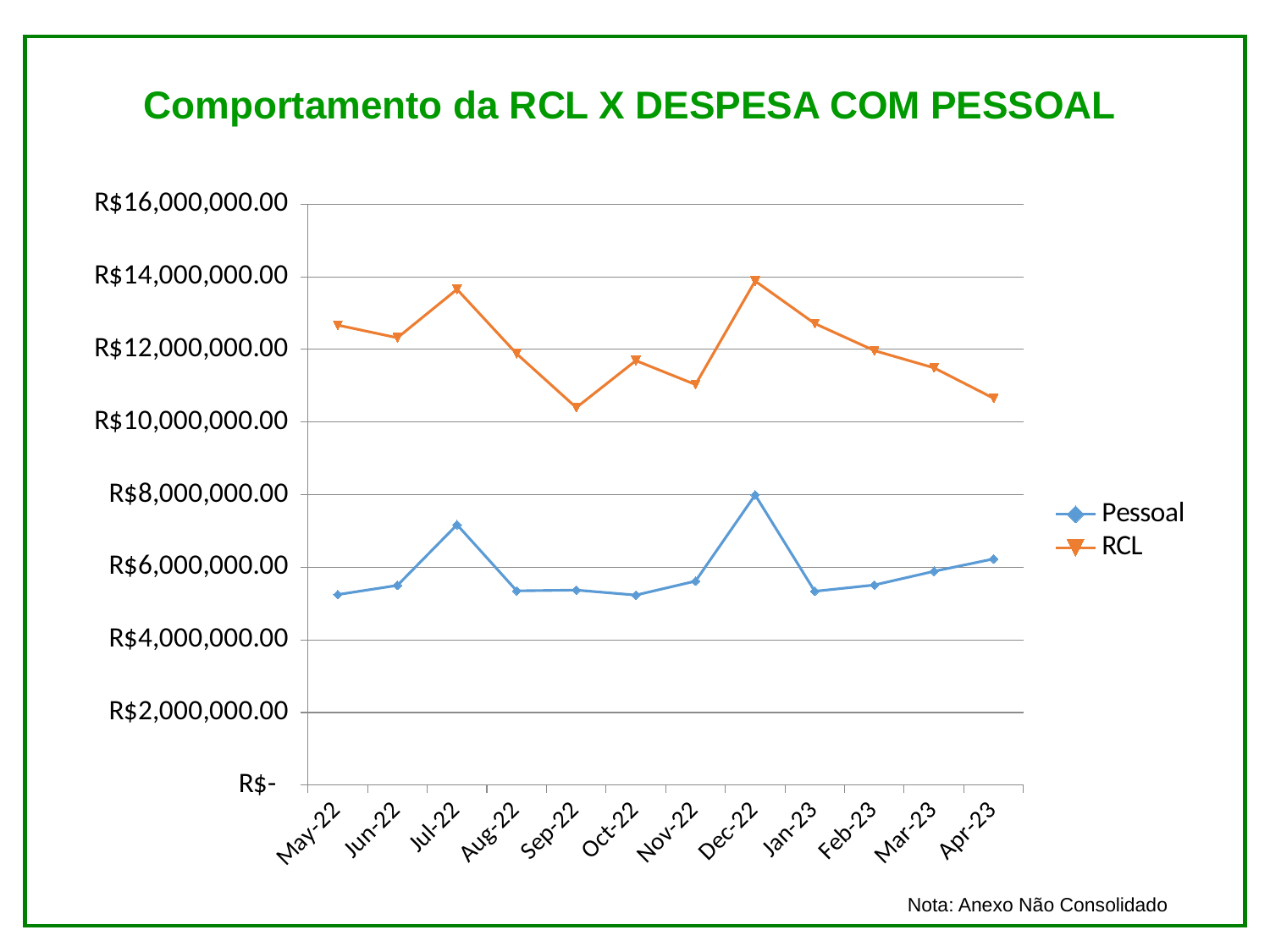
What is the title of the chart? Comportamento da RCL X DESPESA COM PESSOAL Does the RCL series rise or fall from Dec-22 to Apr-23? fall Does the Pessoal series rise or fall from Jan-23 to Apr-23? rise How many months are plotted along the x axis? 12 Is the RCL value for Jul-22 greater or less than R$12,000,000.00? greater How many series does the legend list? 2 In which month does the Pessoal series reach its highest value? Dec-22 In which month does the RCL series reach its lowest value? Sep-22 Is the RCL value for Sep-22 greater or less than R$12,000,000.00? less Is the Pessoal value for Dec-22 greater or less than R$6,000,000.00? greater What kind of chart is shown on the slide? line chart Which series has the larger value in Dec-22, Pessoal or RCL? RCL